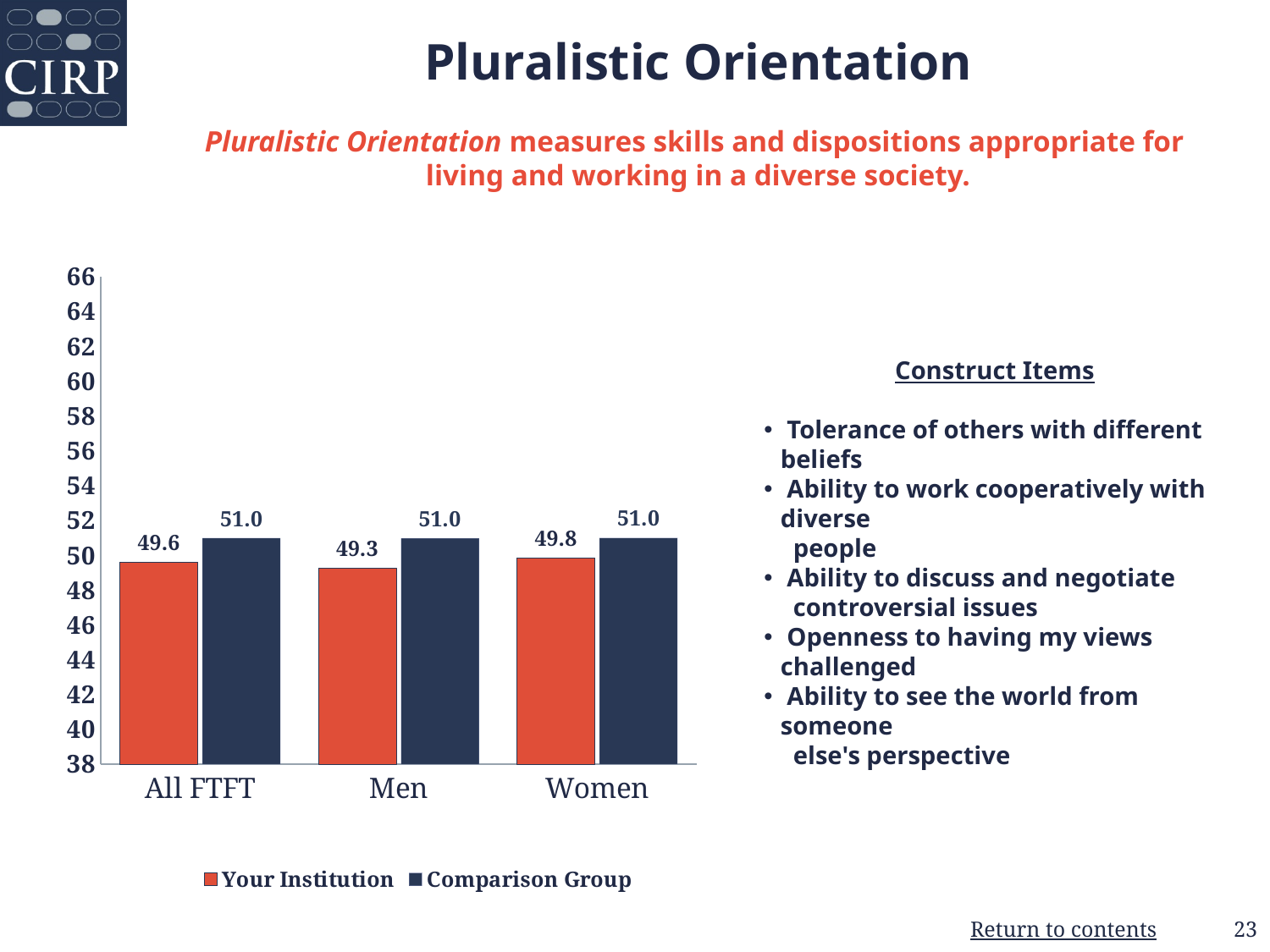
What is the difference between the Your Institution values for Women and Men? 0.5 What colour are the Your Institution bars? orange-red How many categories are shown on the x axis? 3 What is the Your Institution value for Men? 49.3 For All FTFT, which is larger: Your Institution or Comparison Group? Comparison Group What is the Your Institution value for All FTFT? 49.6 How many series does the legend list? 2 Which category has the lowest Your Institution value? Men What is the Comparison Group value for Women? 51.0 What is the difference between the Comparison Group and Your Institution values for Men? 1.7 What kind of chart is shown on the slide? bar chart Which category has the highest Your Institution value? Women